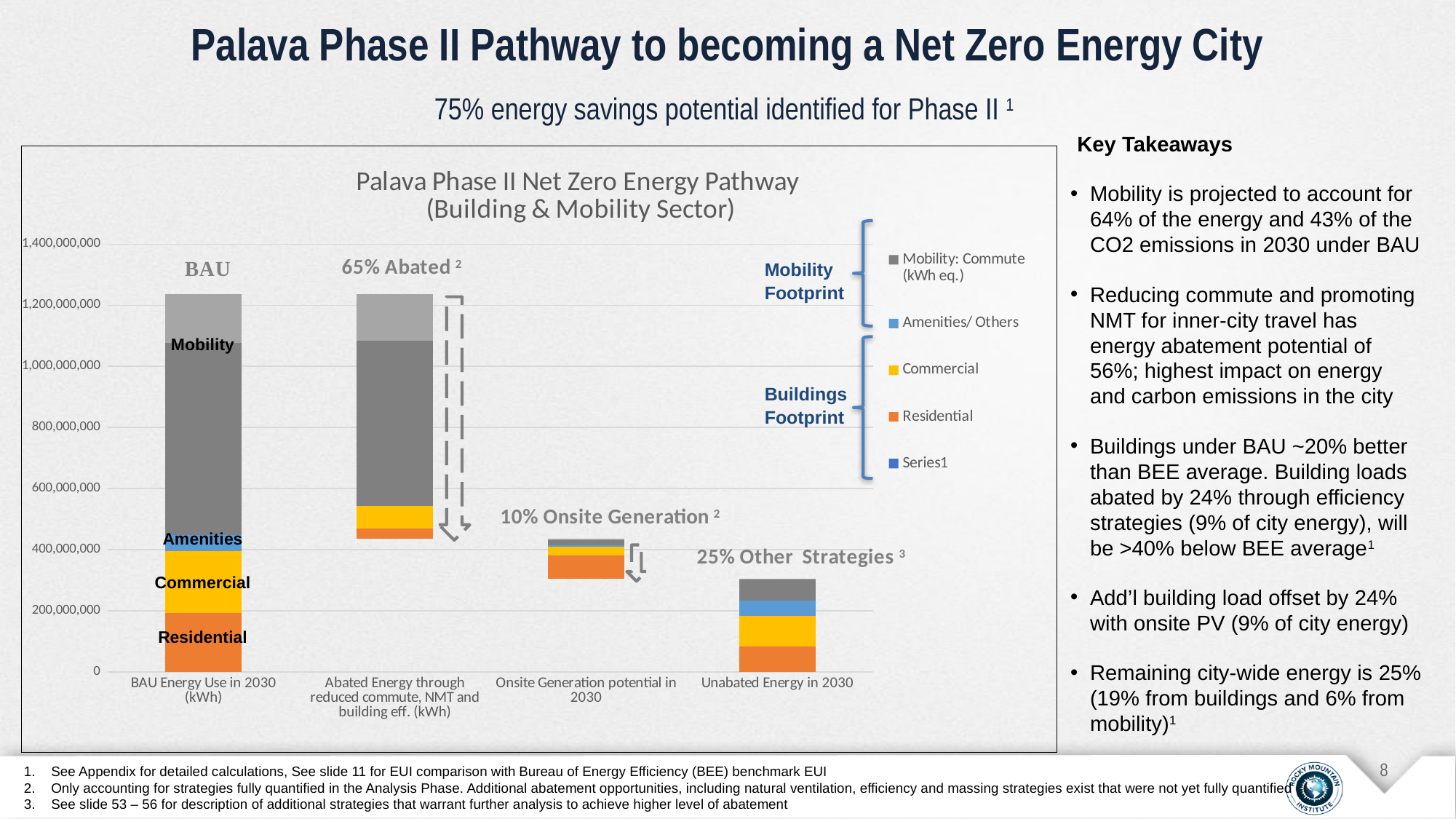
What percentage label is shown for the 'Unabated Energy in 2030' bar? 25% Other Strategies What type of chart is shown on the slide? Stacked bar chart What is the title of the chart? Palava Phase II Net Zero Energy Pathway (Building & Mobility Sector) How many categories are shown along the x axis of the chart? 4 Is the top of the 'Unabated Energy in 2030' bar greater or less than 400,000,000? less Is the total value of the 'BAU Energy Use in 2030 (kWh)' bar greater or less than 1,000,000,000? greater What percentage is labelled above the 'Abated Energy through reduced commute, NMT and building eff. (kWh)' bar? 65% Abated Which bar reaches a higher value: 'BAU Energy Use in 2030 (kWh)' or 'Unabated Energy in 2030'? BAU Energy Use in 2030 (kWh) Is the top of the 'Onsite Generation potential in 2030' bar greater or less than 600,000,000? less What percentage label is shown for the 'Onsite Generation potential in 2030' bar? 10% Onsite Generation Which legend entry is shown in orange? Residential How many series does the chart legend list? 5